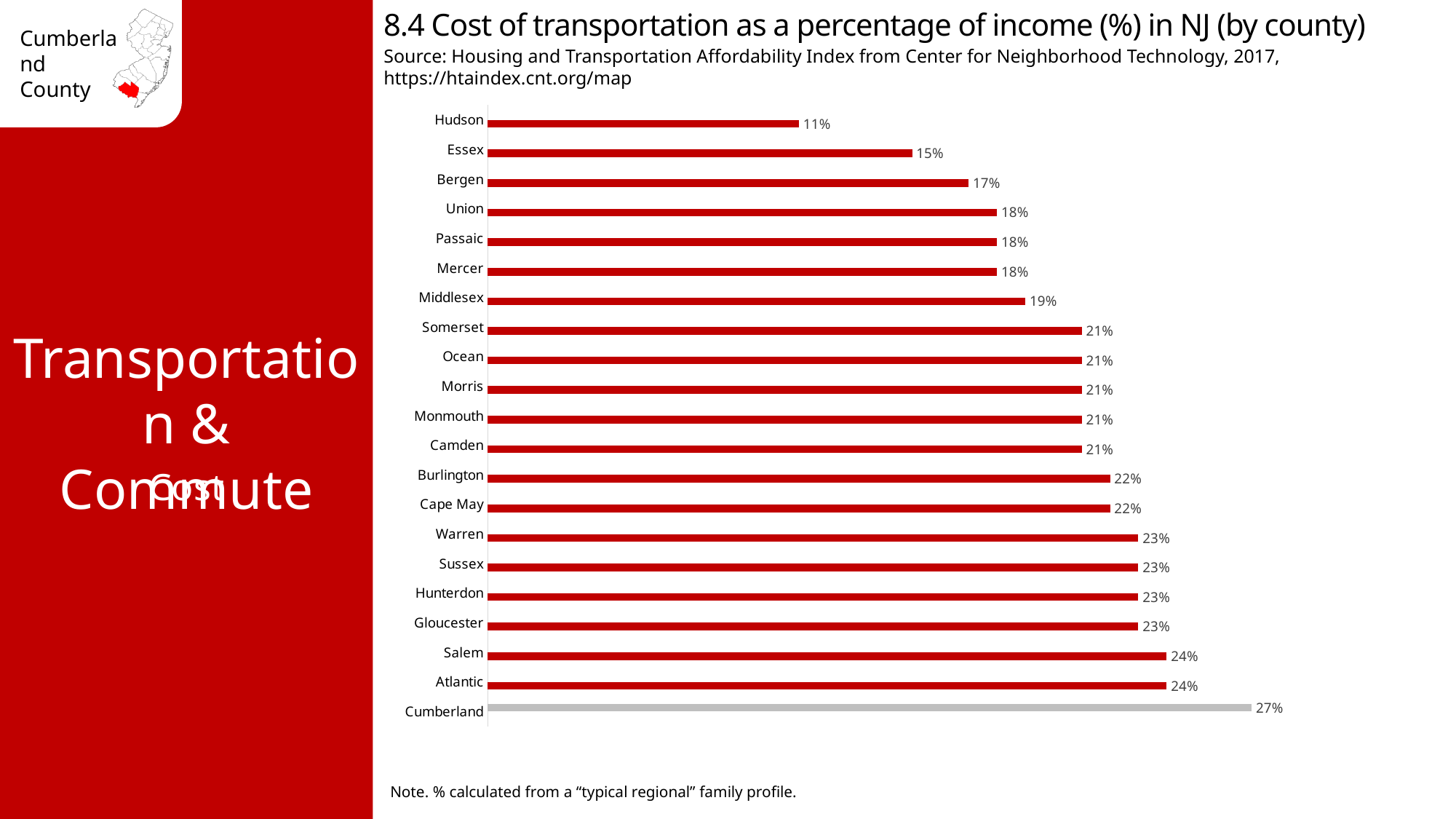
What is the difference in percentage points between Cumberland and Hudson? 16 What is the cost of transportation as a percentage of income for Cumberland county? 27% Which county has the lowest cost of transportation as a percentage of income? Hudson What is the difference in percentage points between Salem and Essex? 9 Which county's bar is shown in a different colour (grey) from the others? Cumberland Which county has the highest cost of transportation as a percentage of income? Cumberland Which county has a higher value, Warren or Union? Warren What is the value shown for Middlesex county? 19% What type of chart is used on this slide? Bar chart What is the value shown for Bergen county? 17% How many counties are shown in the chart? 21 What is the cost of transportation as a percentage of income for Hudson county? 11%